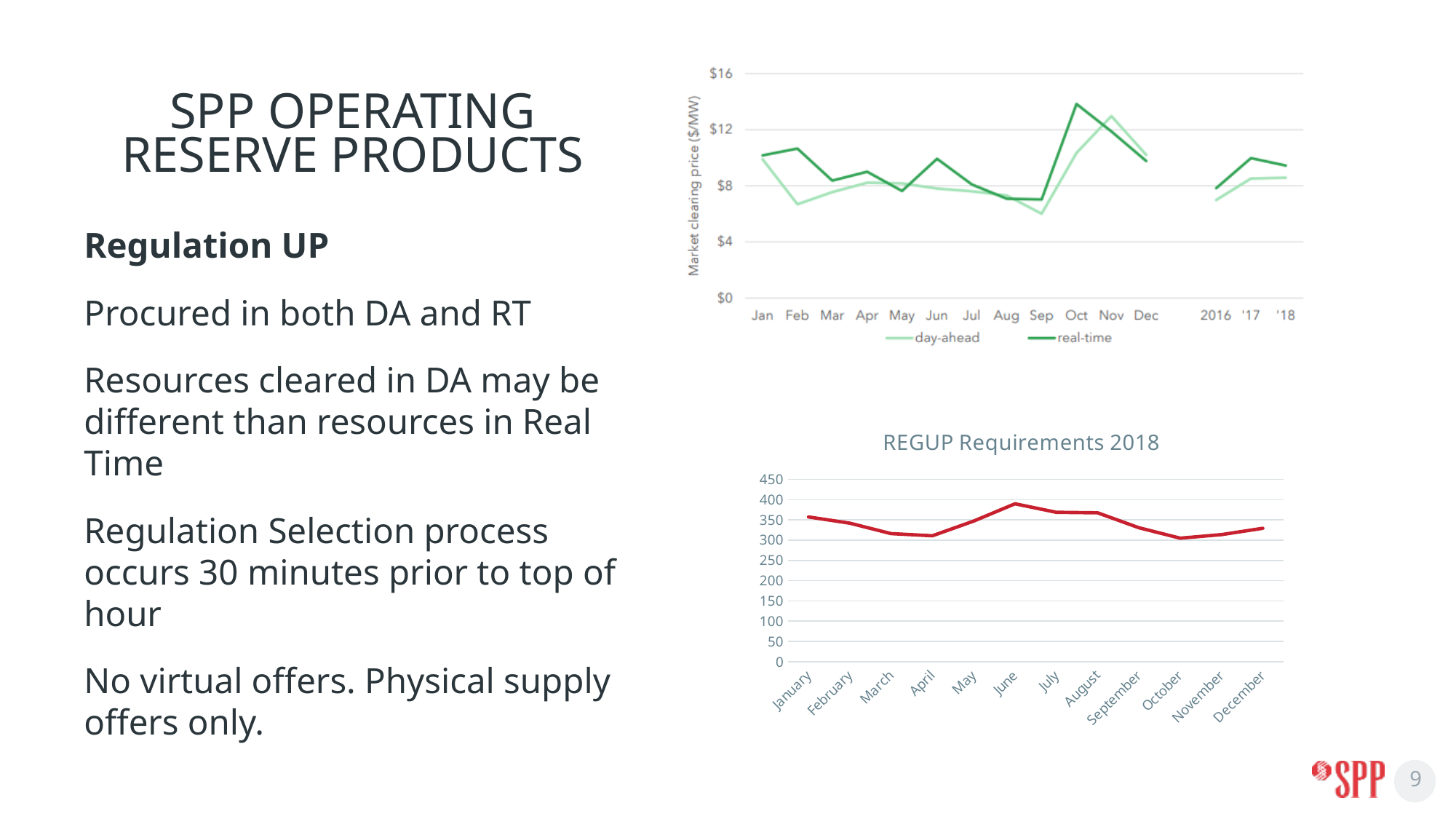
In the REGUP Requirements 2018 chart, do the values rise or fall from October to December? rise In the REGUP Requirements 2018 chart, which month has the highest requirement? June In the REGUP Requirements 2018 chart, do the values rise or fall from January to April? fall In the REGUP Requirements 2018 chart, is the value for October greater or less than 350? less How many series does the legend of the top market clearing price chart list? 2 In the top market clearing price chart, which month has the highest real-time price? Oct In the top market clearing price chart, which is larger in Feb, the day-ahead price or the real-time price? real-time In the top market clearing price chart, is the real-time price for Oct greater or less than $12? greater In the REGUP Requirements 2018 chart, is the value for June greater or less than 350? greater How many months are plotted on the x axis of the REGUP Requirements 2018 chart? 12 What kind of chart is the REGUP Requirements 2018 chart? line chart What is the y-axis label of the top chart? Market clearing price ($/MW)